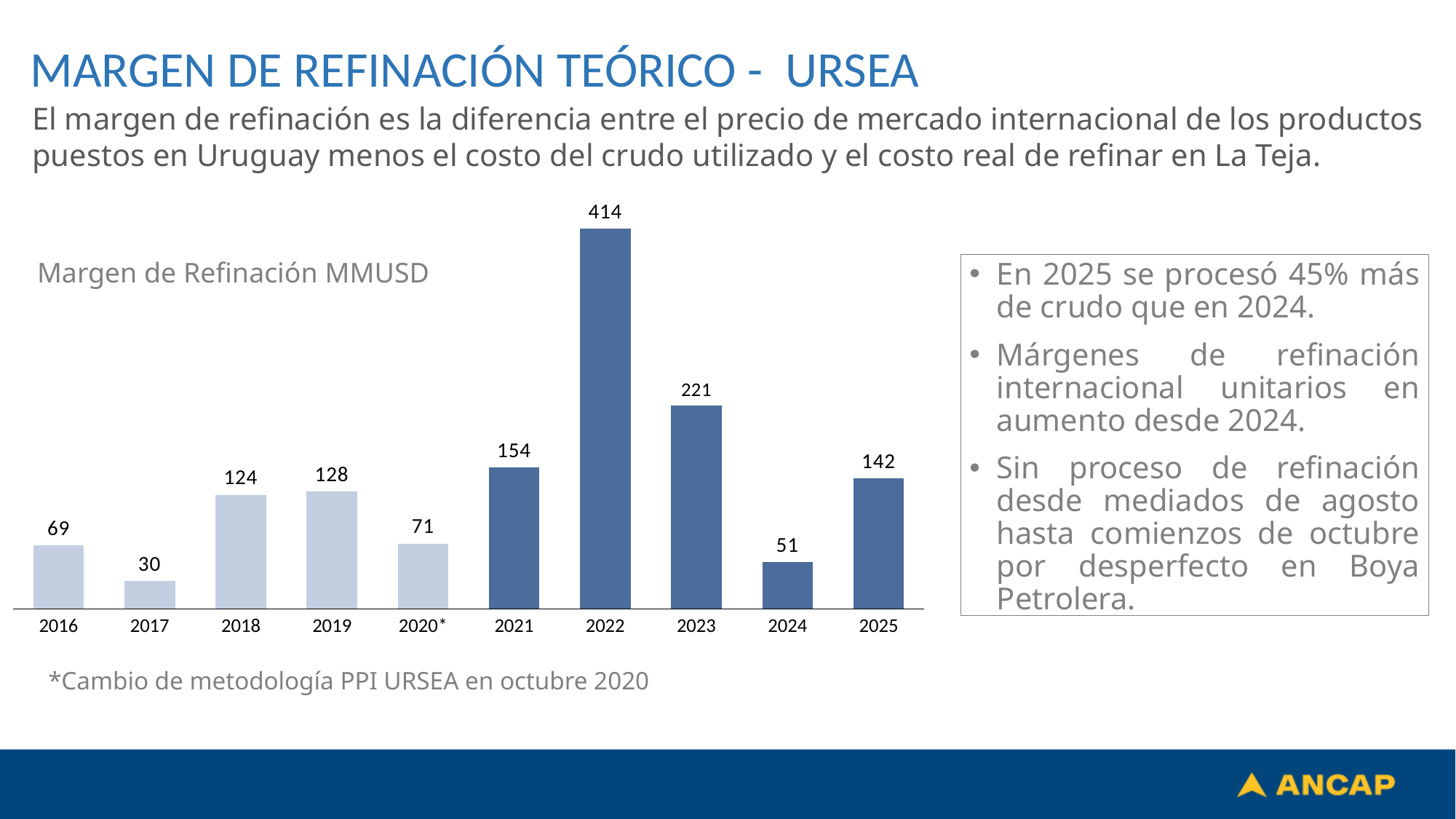
Which year has the lowest value in the Margen de Refinación MMUSD chart? 2017 What kind of chart is the Margen de Refinación MMUSD chart? Bar chart Do the values in the Margen de Refinación MMUSD chart rise or fall from 2022 to 2024? Fall Which is larger in the Margen de Refinación MMUSD chart, the value for 2019 or the value for 2021? 2021 What is the value for 2020* in the Margen de Refinación MMUSD chart? 71 What is the difference between the values for 2022 and 2023 in the Margen de Refinación MMUSD chart? 193 What is the title of the chart on the slide? Margen de Refinación MMUSD What is the value for 2022 in the Margen de Refinación MMUSD chart? 414 How many years are shown in the Margen de Refinación MMUSD chart? 10 Which year has the highest value in the Margen de Refinación MMUSD chart? 2022 What is the value for 2024 in the Margen de Refinación MMUSD chart? 51 What is the difference between the values for 2025 and 2024 in the Margen de Refinación MMUSD chart? 91